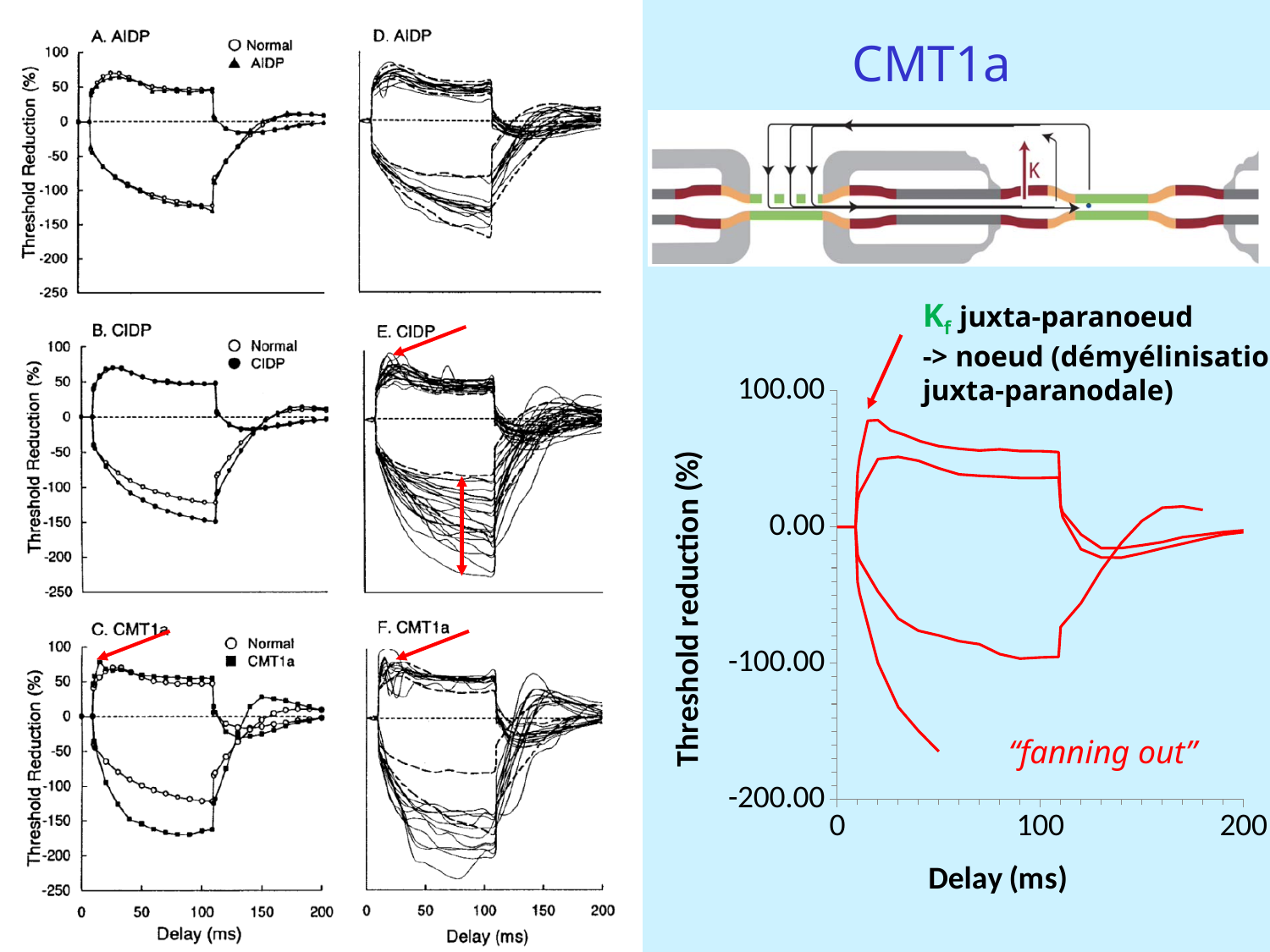
In panel B (CIDP) on the left, what are the two series named in the legend? Normal and CIDP In panel C (CMT1a) on the left, which series reaches the lower value at a delay of 100 ms, Normal or CMT1a? CMT1a On the right-hand chart titled CMT1a, what is the highest value shown on the x axis? 200 On the right-hand chart titled CMT1a, what is the lowest value shown on the y axis? -200.00 On the right-hand chart titled CMT1a, what is the label of the x axis? Delay (ms) In panel C (CMT1a) on the left, how many series does the legend list? 2 In panel A (AIDP) on the left, is the lower curve at a delay of 100 ms greater or less than -100? less On the right-hand chart titled CMT1a, what is the label of the y axis? Threshold reduction (%) In panel C (CMT1a) on the left, is the CMT1a series value at a delay of 100 ms greater or less than -150? less What kind of chart is the right-hand chart titled CMT1a? line chart On the right-hand chart titled CMT1a, is the lowest red trace at a delay of about 50 ms greater or less than -100.00? less